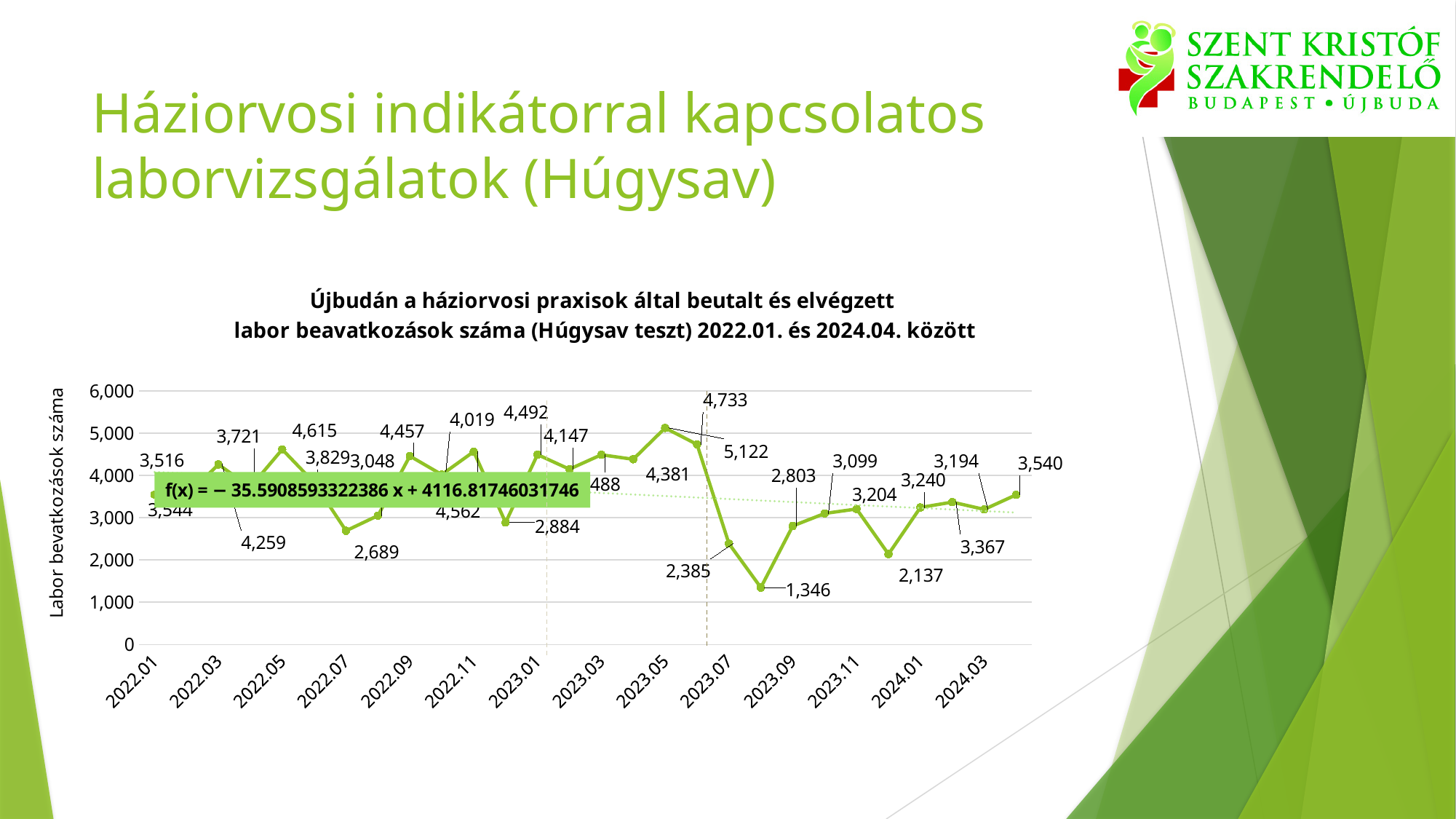
What kind of chart is shown on the slide? line chart How many monthly data points are plotted on the chart? 28 What is the value for 2023.08? 1,346 What is the highest value plotted on the chart? 5,122 What is the value for 2023.12? 2,137 Which month has the lowest number of lab interventions? 2023.08 What is the value for 2024.04, the last point on the chart? 3,540 Which is larger, the value for 2023.05 or the value for 2023.07? 2023.05 Which month has the highest number of lab interventions? 2023.05 What is the label of the vertical axis? Labor bevatkozások száma Is the value for 2023.08 greater or less than 2,000? less What is the difference between the highest value (5,122) and the lowest value (1,346)? 3,776